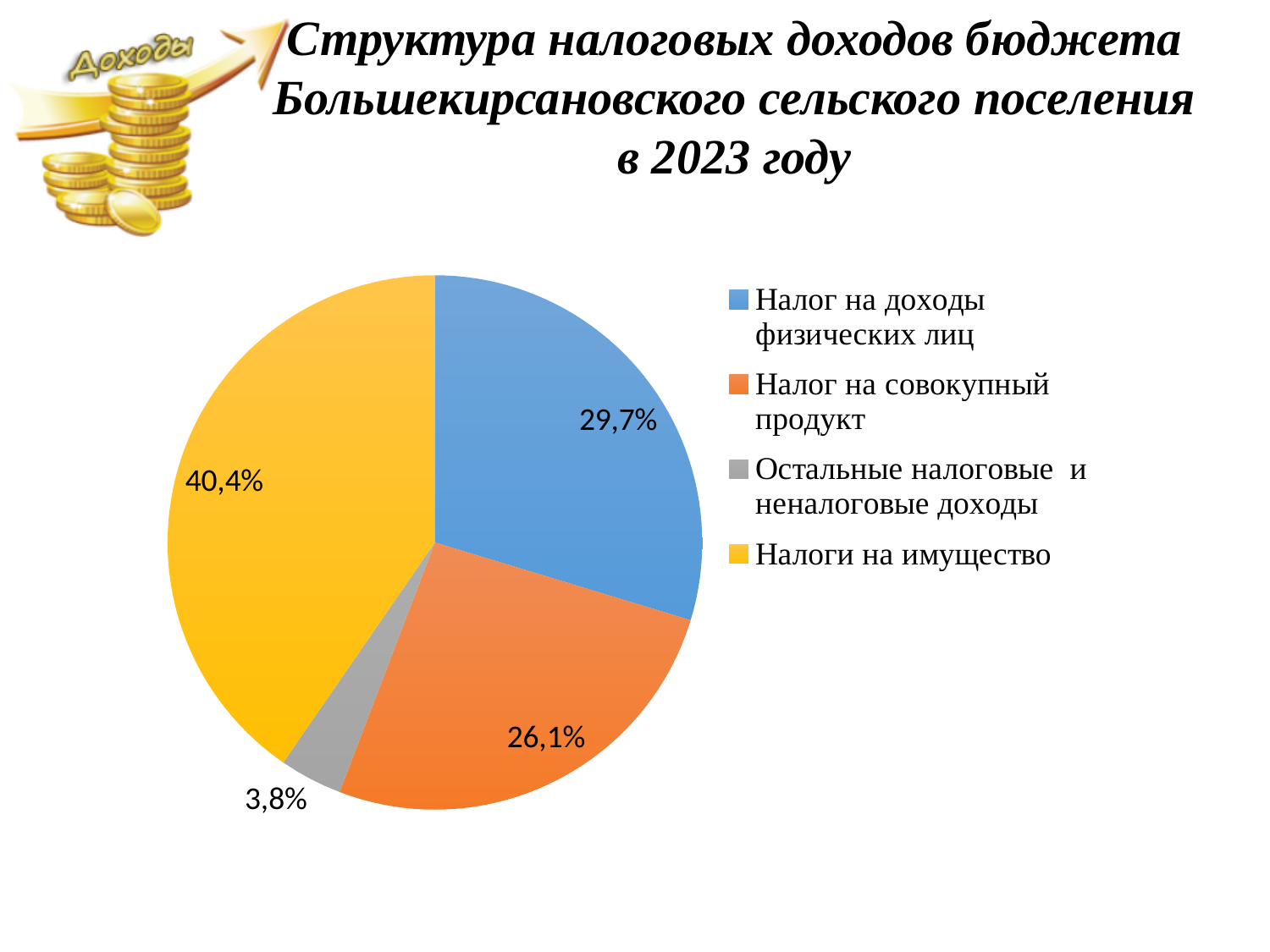
What share of the pie does Остальные налоговые и неналоговые доходы have? 3,8% What is the title of the slide? Структура налоговых доходов бюджета Большекирсановского сельского поселения в 2023 году Which category has the largest slice of the pie? Налоги на имущество What colour is the slice for Налоги на имущество? Yellow What is the difference in percentage points between Налоги на имущество and Налог на доходы физических лиц? 10,7 Which category has the smallest slice of the pie? Остальные налоговые и неналоговые доходы What kind of chart is shown on the slide? Pie chart What share of the pie does Налоги на имущество have? 40,4% How many slices does the pie chart have? 4 What share of the pie does Налог на совокупный продукт have? 26,1% What share of the pie does Налог на доходы физических лиц have? 29,7% Which is larger: the slice for Налог на доходы физических лиц or the slice for Налог на совокупный продукт? Налог на доходы физических лиц